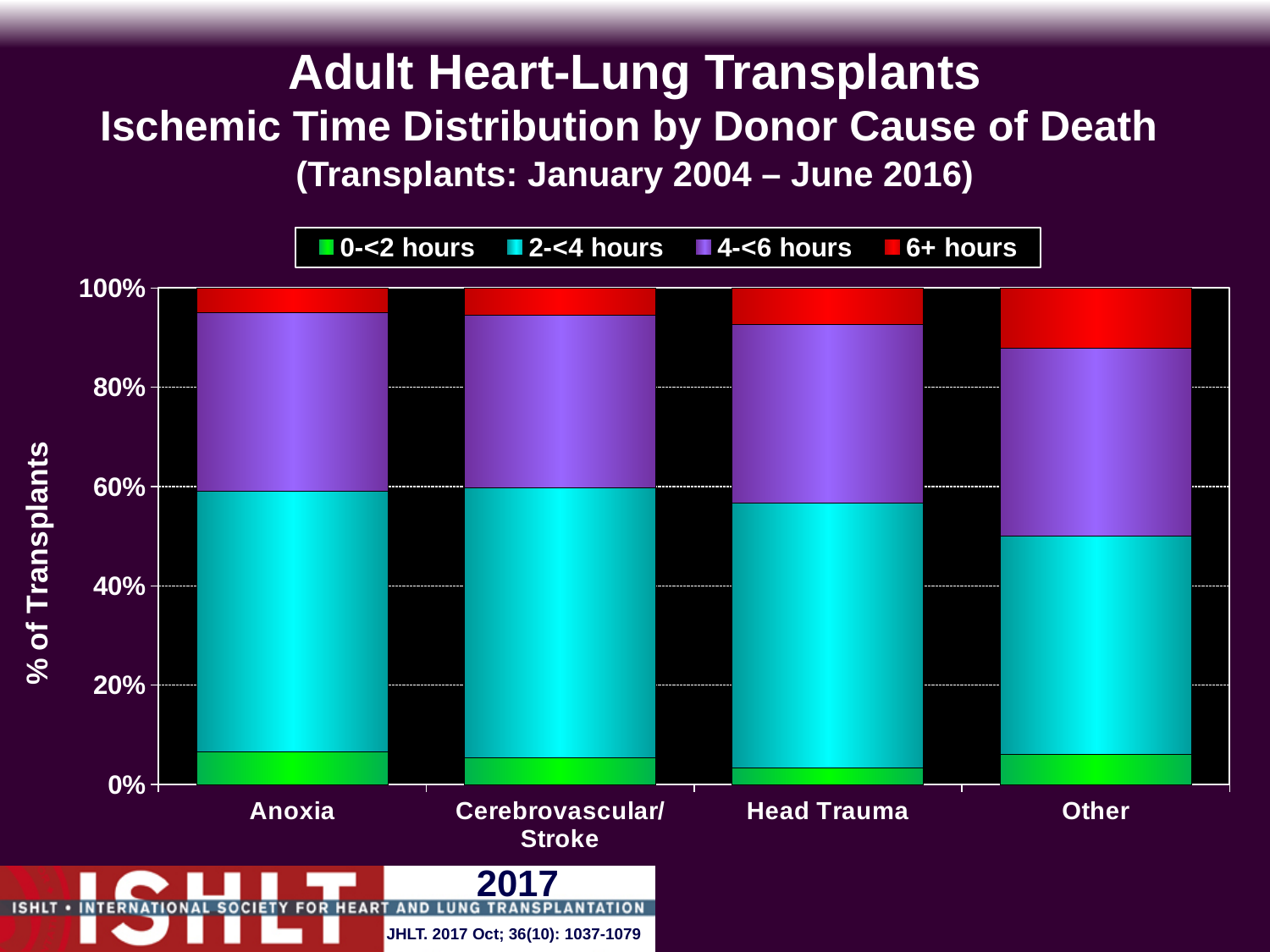
For Head Trauma, is the combined share of transplants with ischemic time under 6 hours greater or less than 80%? greater Is the 0-<2 hours share larger for Anoxia or for Head Trauma? Anoxia Which donor cause of death has the smallest 2-<4 hours share? Other How many series does the legend list? 4 Which ischemic time category is shown in red in the legend? 6+ hours Which donor cause of death has the largest 6+ hours share? Other How many donor cause of death categories are shown on the x axis? 4 Is the 6+ hours share larger for Other or for Anoxia? Other What is the label of the y axis? % of Transplants Which donor cause of death has the smallest 0-<2 hours share? Head Trauma For Other, is the combined share of transplants with ischemic time under 4 hours greater or less than 60%? less What kind of chart is shown on the slide? Stacked bar chart